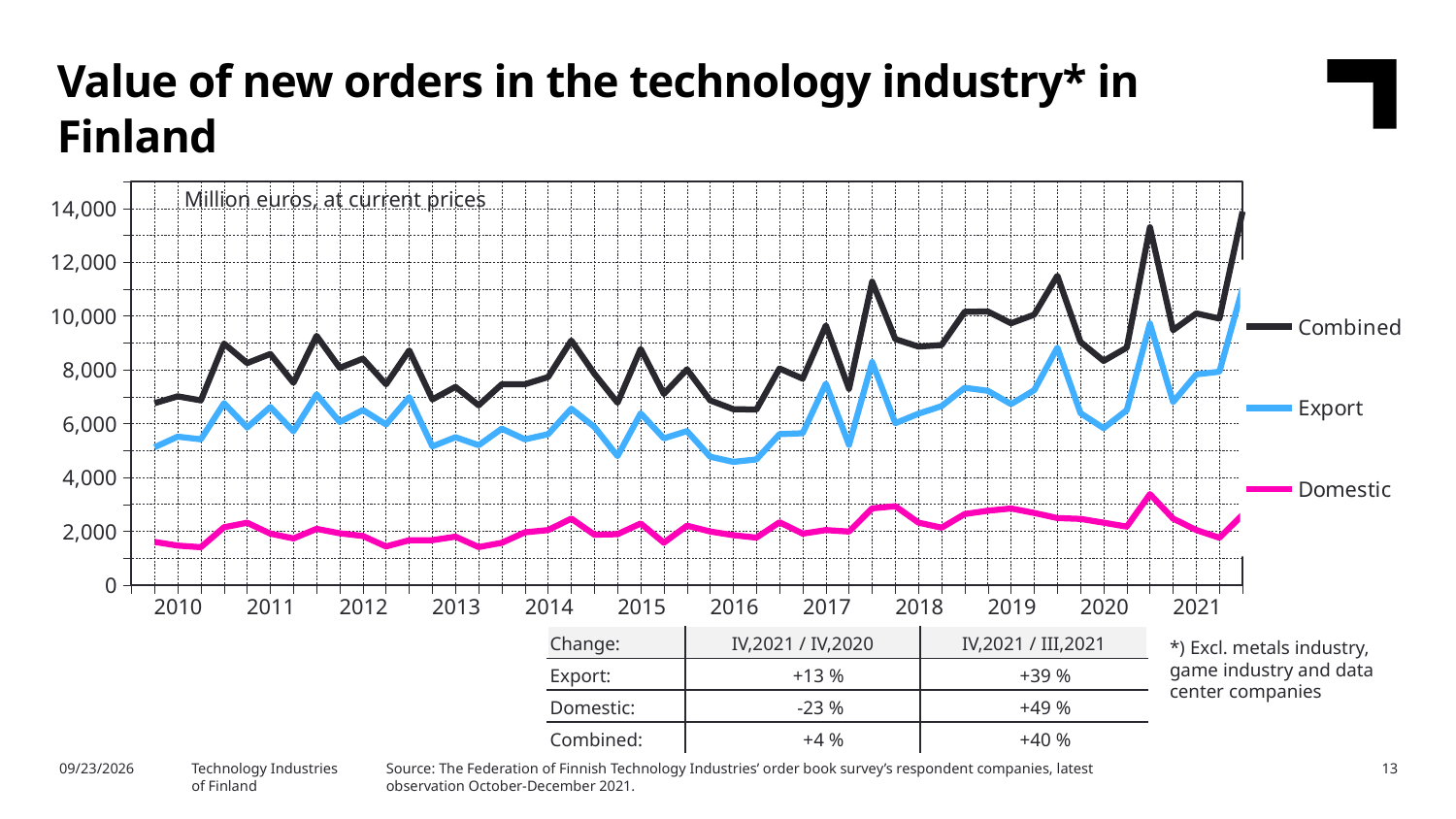
Which series is the lowest throughout the whole period shown? Domestic What are the three series named in the chart legend? Combined, Export, Domestic What unit label is printed inside the chart area? Million euros, at current prices Is the value of the Domestic line at the start of 2010 greater or less than 2,000? less Is the value of the Combined line at the end of 2021 greater or less than 12,000? greater Which series is the highest throughout the whole period shown? Combined Is the lowest value of the Export line in 2016 greater or less than 6,000? less Does the Combined line end in 2021 higher or lower than it started in 2010? higher How many years are labeled on the x axis of the chart? 12 What type of chart is shown on the slide? Line chart How many series does the chart's legend list? 3